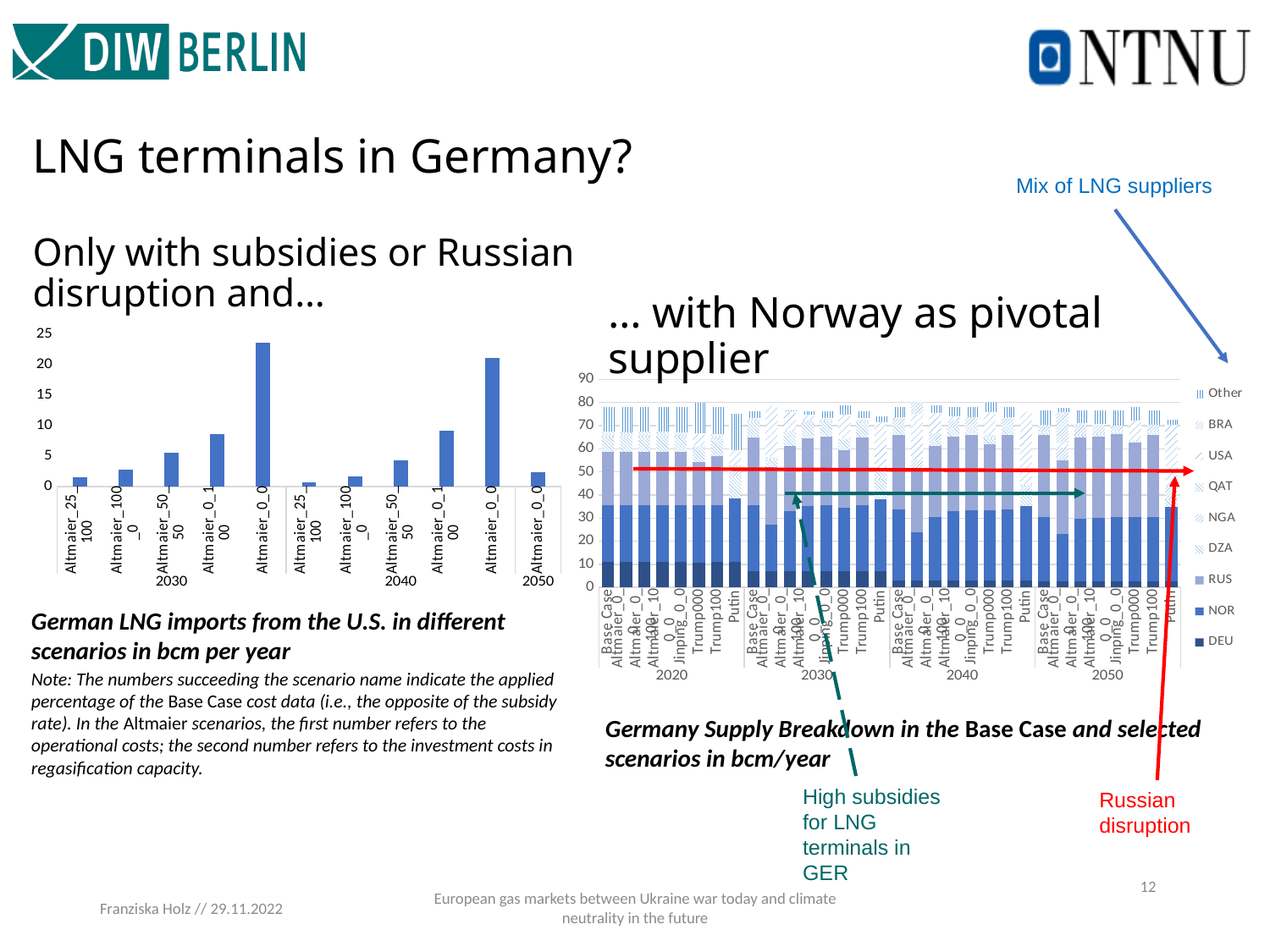
In the left chart on German LNG imports from the U.S., is the value for Altmaier_0_0 in 2030 greater or less than 20? greater In the left chart on German LNG imports from the U.S., is the value for Altmaier_0_100 in 2030 greater or less than 10? less What kind of chart is the left chart, 'German LNG imports from the U.S. in different scenarios in bcm per year'? bar chart In the left chart on German LNG imports from the U.S., which scenario and year has the highest value? Altmaier_0_0 in 2030 In the left chart on German LNG imports from the U.S., do the values rise or fall across the 2030 scenarios from Altmaier_25_100 to Altmaier_0_0? rise What kind of chart is the right chart on Germany Supply Breakdown? stacked bar chart In the left chart on German LNG imports from the U.S., how many bars are plotted? 11 In the left chart on German LNG imports from the U.S., is the value for Altmaier_0_0 in 2050 greater or less than 5? less How many series does the legend of the right chart, 'Germany Supply Breakdown in the Base Case and selected scenarios in bcm/year', list? 9 In the left chart on German LNG imports from the U.S., which is larger in 2030: Altmaier_0_100 or Altmaier_50_50? Altmaier_0_100 In the left chart on German LNG imports from the U.S., which scenario and year has the lowest value? Altmaier_25_100 in 2040